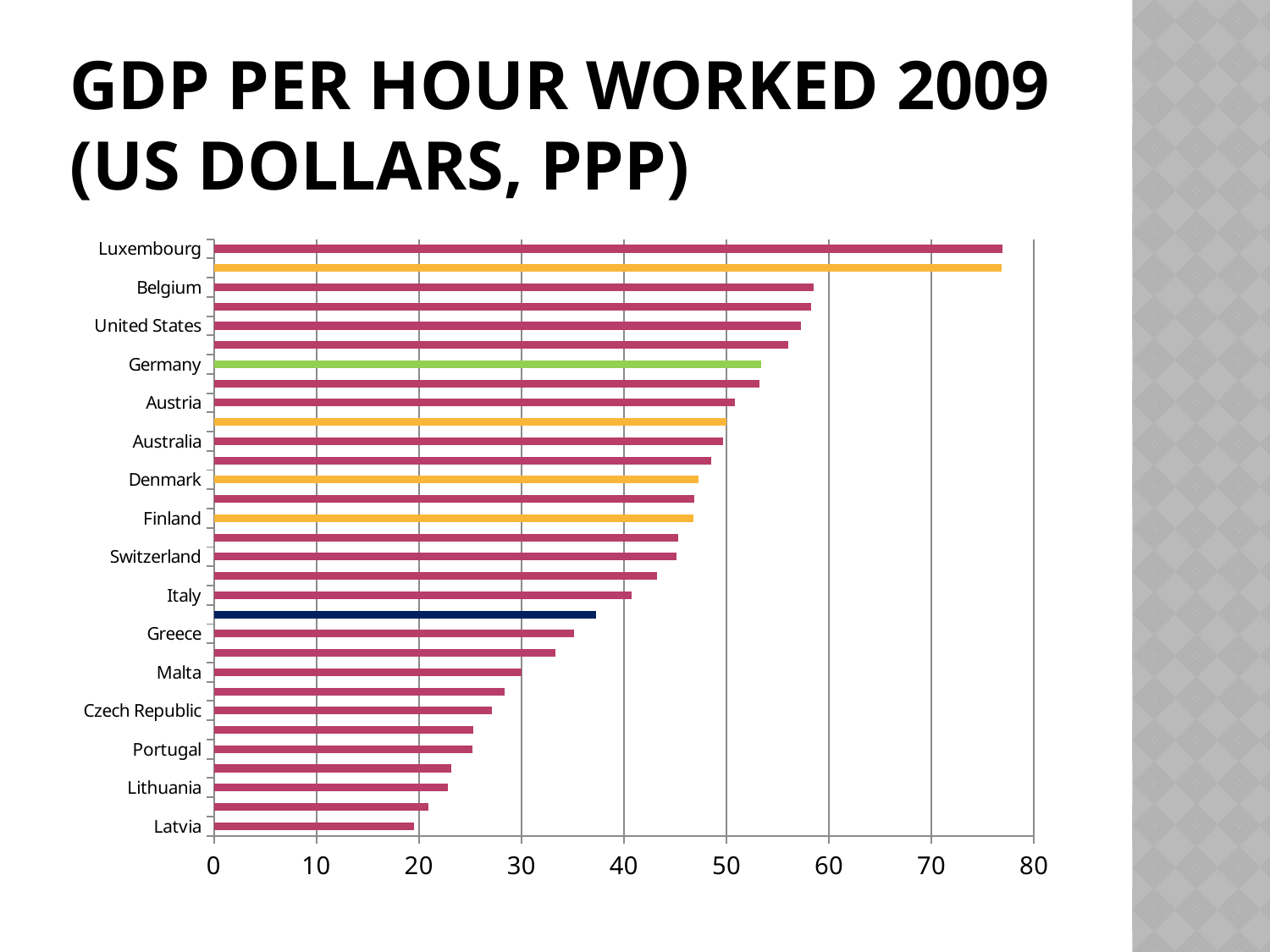
Is the value for Denmark greater or less than 50? less Is the value for Portugal greater or less than 30? less What colour is the bar for Germany? green Which has a higher GDP per hour worked, Belgium or Greece? Belgium Is the value for Latvia greater or less than 30? less Do the bar values increase or decrease going from the top of the chart to the bottom? decrease Which labelled country has the lowest GDP per hour worked? Latvia What kind of chart is shown on the slide? bar chart Which labelled country has the highest GDP per hour worked? Luxembourg